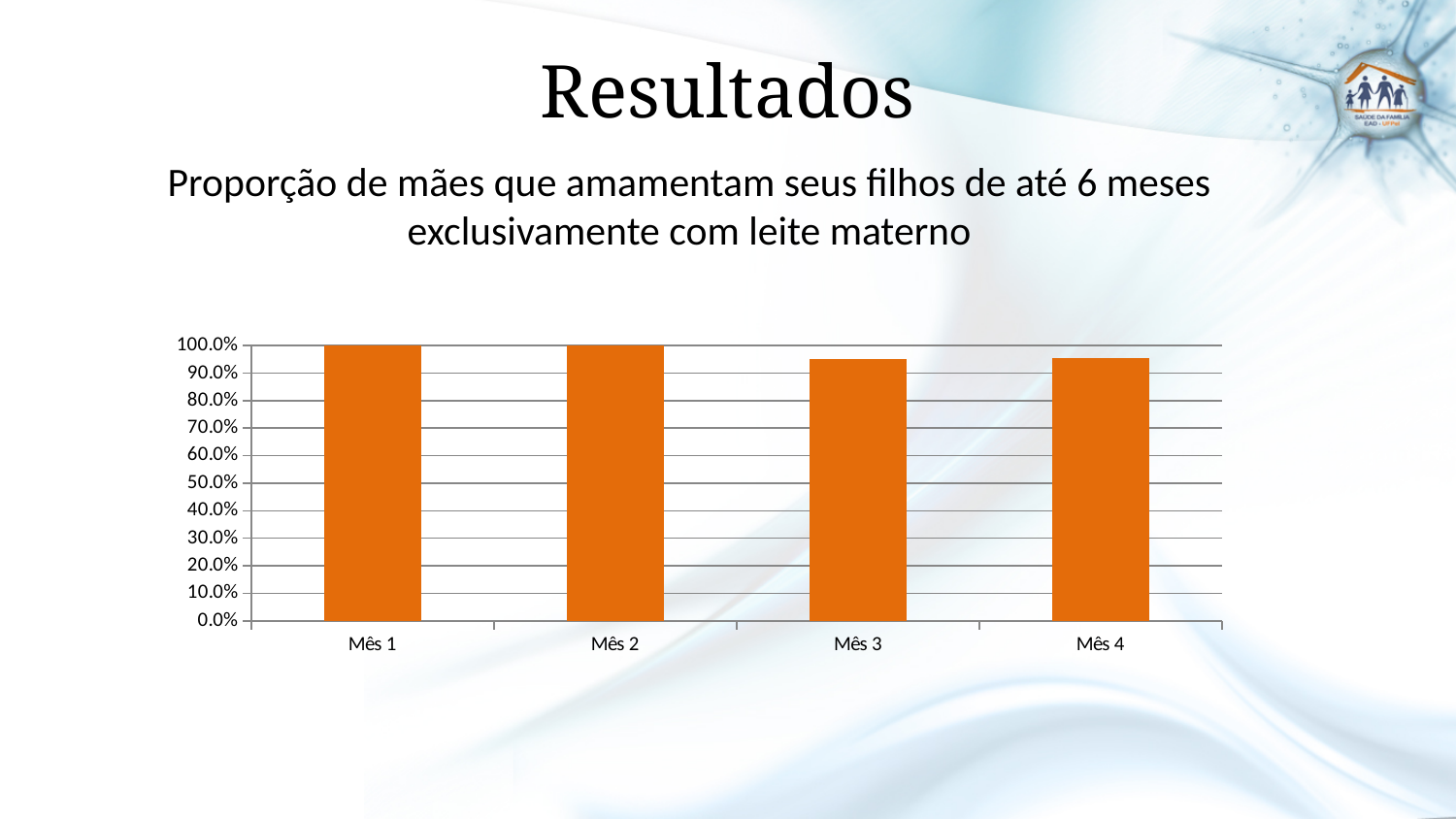
What is the value for Mês 1? 100.0% Is the value for Mês 3 greater or less than 100.0%? less What is the value for Mês 2? 100.0% Is the value for Mês 4 greater or less than 100.0%? less How many categories (months) are plotted on the chart? 4 What type of chart is shown on the slide? Bar chart Which is larger, the value for Mês 2 or the value for Mês 4? Mês 2 Is the value for Mês 3 greater or less than 90.0%? greater Which is larger, the value for Mês 1 or the value for Mês 3? Mês 1 Do the values rise or fall from Mês 2 to Mês 3? fall What is the title of the chart? Proporção de mães que amamentam seus filhos de até 6 meses exclusivamente com leite materno What colour are the bars in the chart? Orange